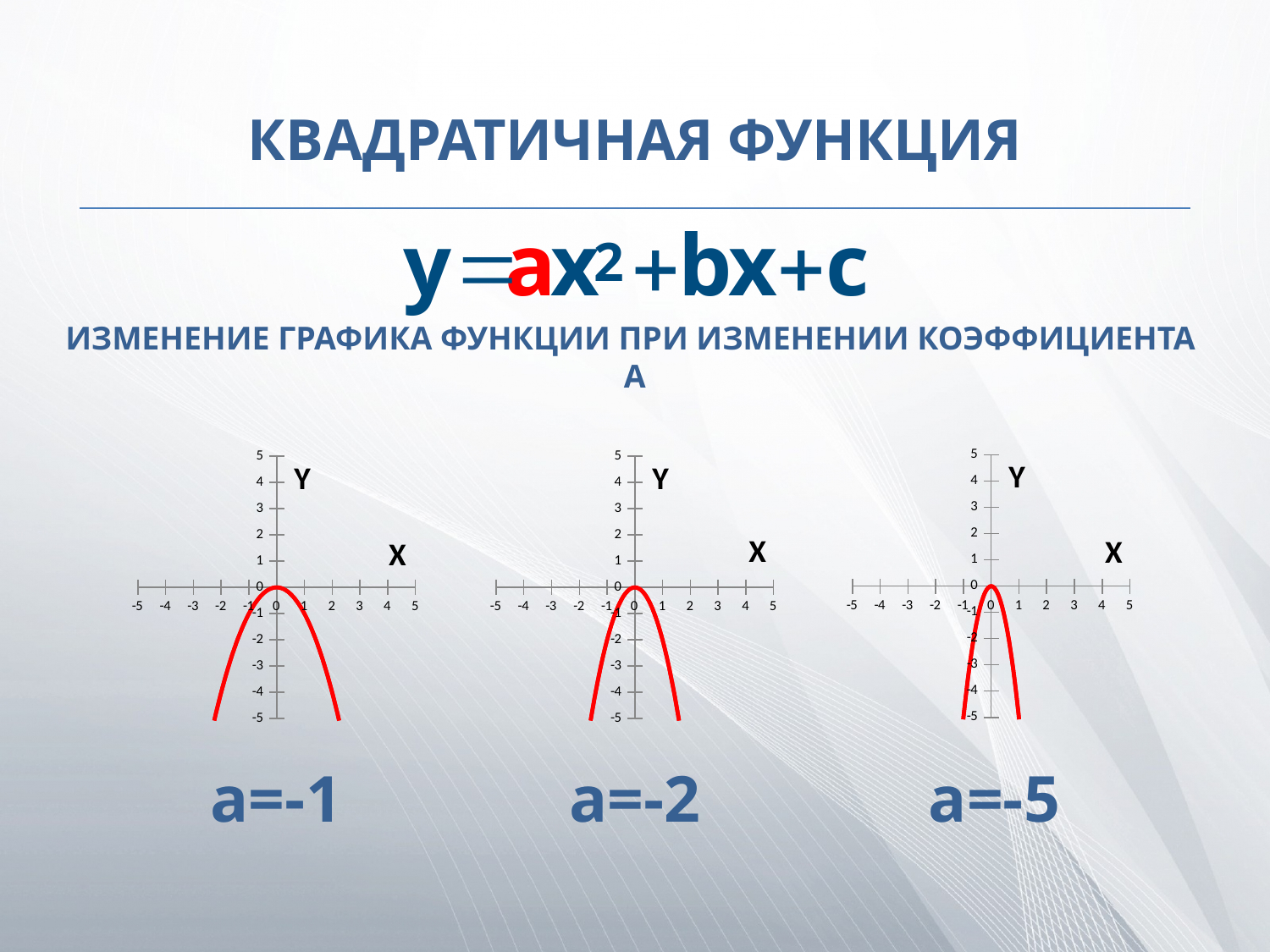
In the left chart (a=-1), is the value of y at x=2 greater or less than -2? less In the left chart (a=-1), what is the value of y at x=0? 0 What kind of chart is the left chart (a=-1)? line chart What is the value of the coefficient a for the middle chart? a=-2 In the middle chart (a=-2), what is the highest value of y reached by the curve? 0 What is the range of the x axis shown in each chart? -5 to 5 What is the value of the coefficient a for the right chart? a=-5 In the right chart (a=-5), does the curve rise or fall as x increases from -1 to 0? rise Which chart shows the narrowest parabola: a=-1, a=-2 or a=-5? a=-5 What colour is the curve plotted in each chart? red In the left chart (a=-1), does the curve rise or fall as x increases from 0 to 2? fall How many charts are shown on the slide? 3